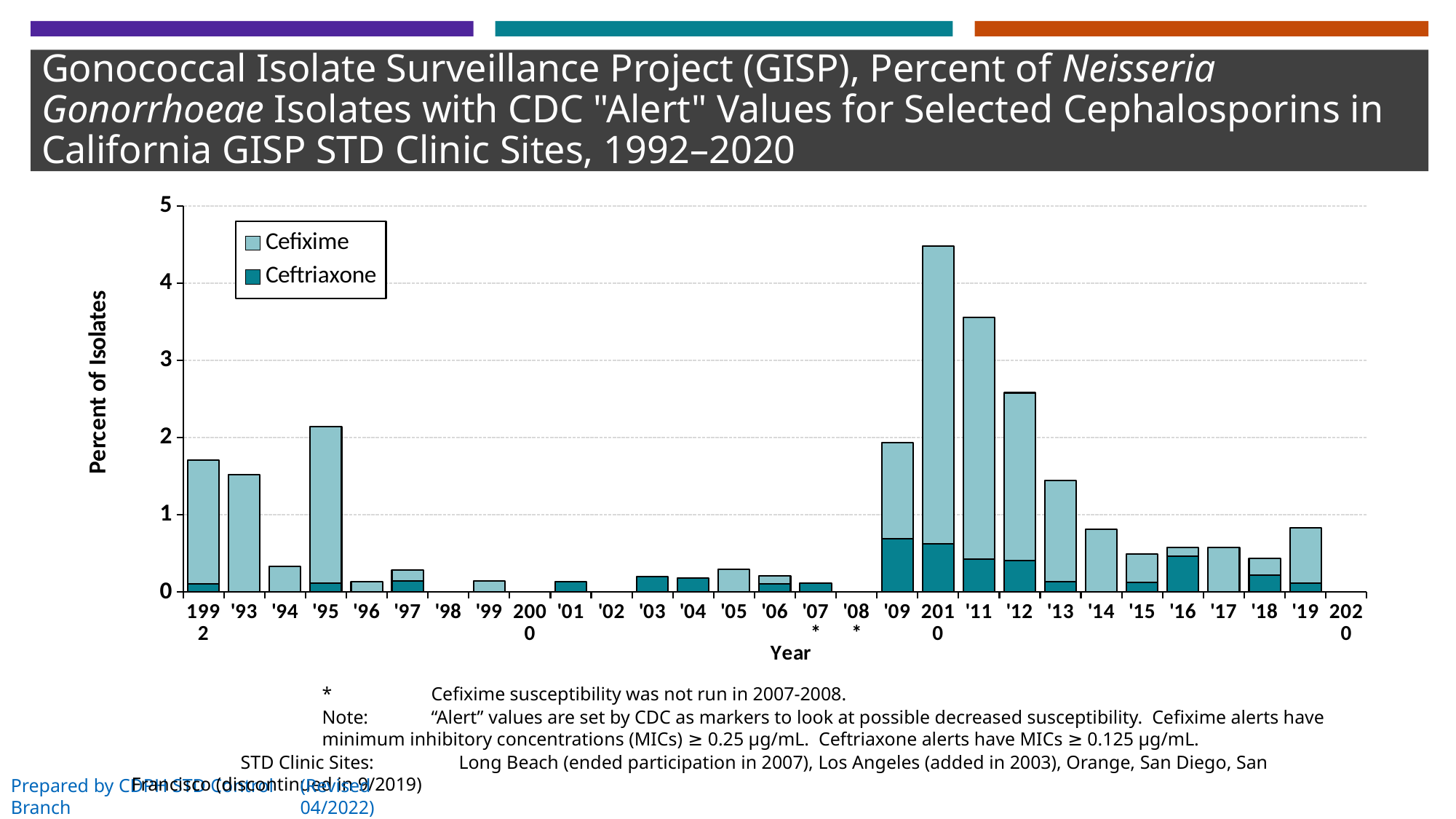
Is the total value for 1992 greater or less than 2? less Is the total value for 2014 greater or less than 1? less What is the title of the vertical axis? Percent of Isolates How many years are shown along the x axis? 29 How many series does the legend list? 2 What kind of chart is shown on the slide? Stacked bar chart Do the total values rise or fall from 2010 to 2014? fall Which year has the tallest stacked bar? 2010 Is the total value for 2010 greater or less than 4? greater Which year has the larger total bar, 2010 or 2011? 2010 Which two series are listed in the legend? Cefixime and Ceftriaxone